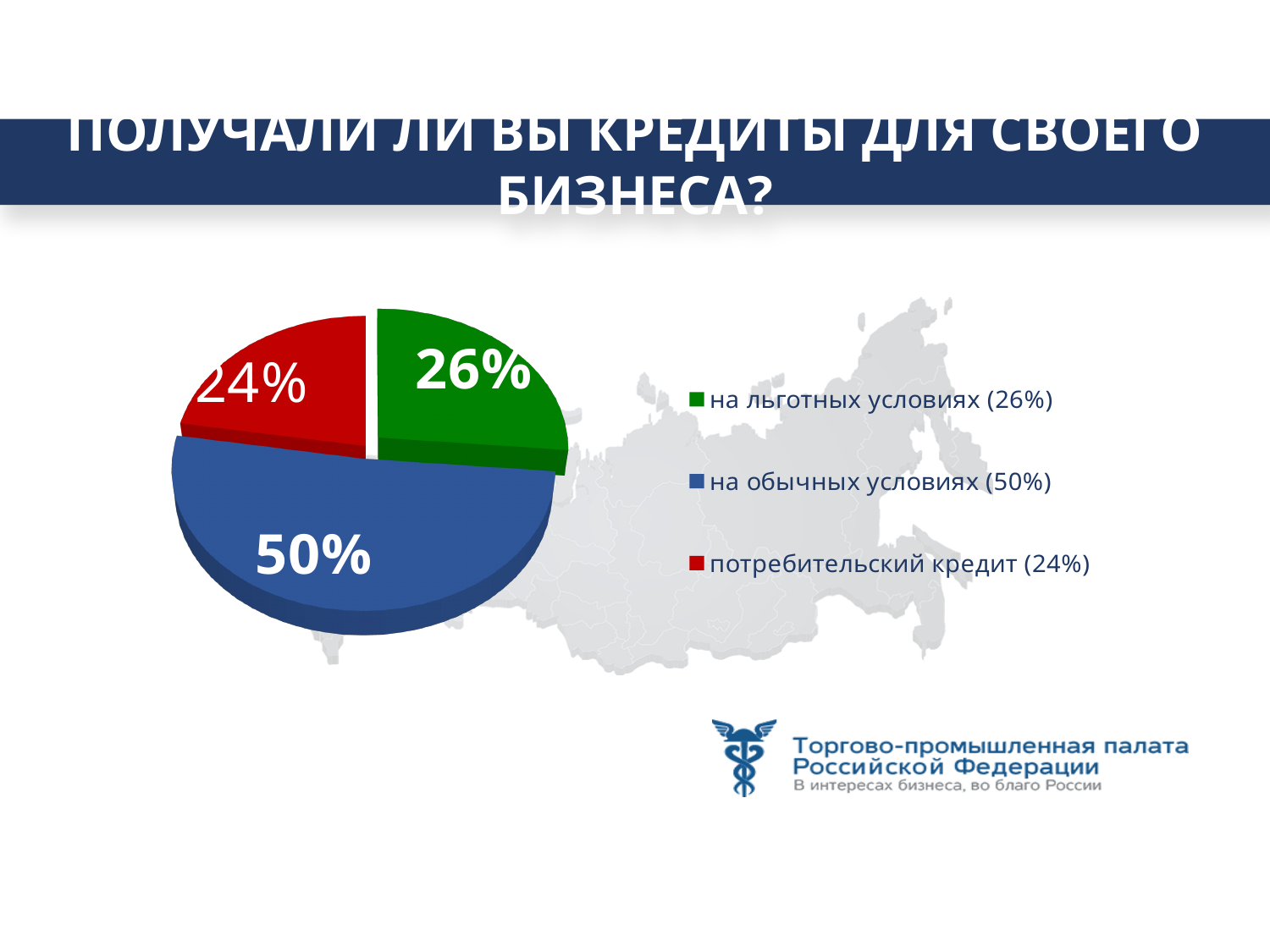
How many entries does the legend list? 3 What share of the pie is labelled "потребительский кредит"? 24% Which category has the largest slice of the pie? на обычных условиях Which colour represents "на льготных условиях" in the pie chart? green What share of the pie is labelled "на льготных условиях"? 26% What share of the pie is labelled "на обычных условиях"? 50% What kind of chart is shown on the slide? pie chart How many slices does the pie chart have? 3 Which category has the smallest slice of the pie? потребительский кредит What is the difference in percentage points between "на обычных условиях" and "на льготных условиях"? 24 What is the difference in percentage points between "на льготных условиях" and "потребительский кредит"? 2 Which colour represents "потребительский кредит" in the pie chart? red